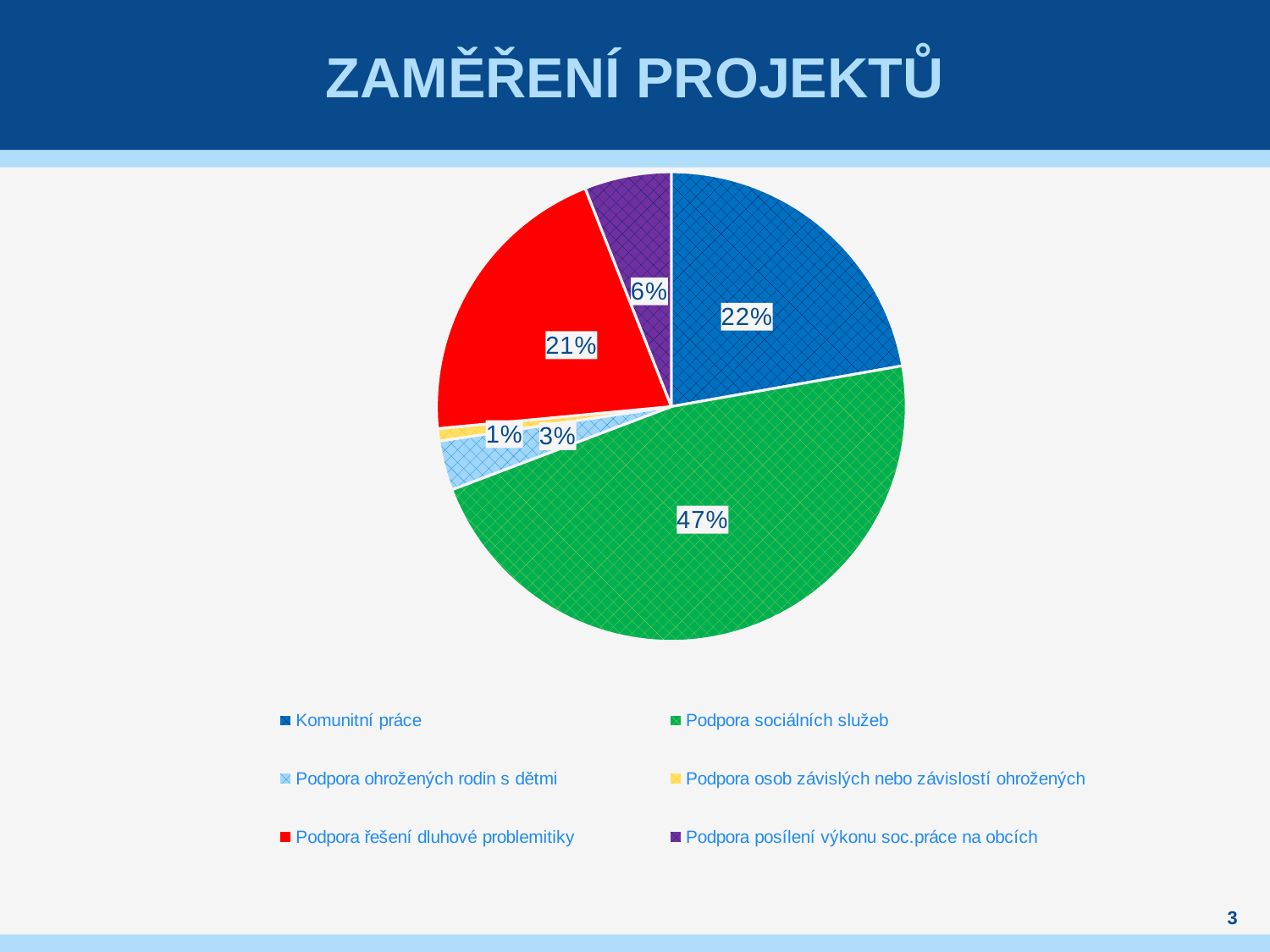
What is the value shown for Podpora posílení výkonu soc.práce na obcích? 6% What is the value shown for Komunitní práce? 22% What is the value shown for Podpora řešení dluhové problemitiky? 21% Which category has the smallest slice of the pie? Podpora osob závislých nebo závislostí ohrožených How many categories does the legend list? 6 What kind of chart is shown on the slide? Pie chart What is the title of the slide containing the chart? ZAMĚŘENÍ PROJEKTŮ What is the value shown for Podpora ohrožených rodin s dětmi? 3% What is the difference between the shares of Podpora sociálních služeb and Komunitní práce? 25% Which category has the largest slice of the pie? Podpora sociálních služeb Which is larger, the share for Komunitní práce or the share for Podpora posílení výkonu soc.práce na obcích? Komunitní práce What share of the pie does Podpora sociálních služeb have? 47%